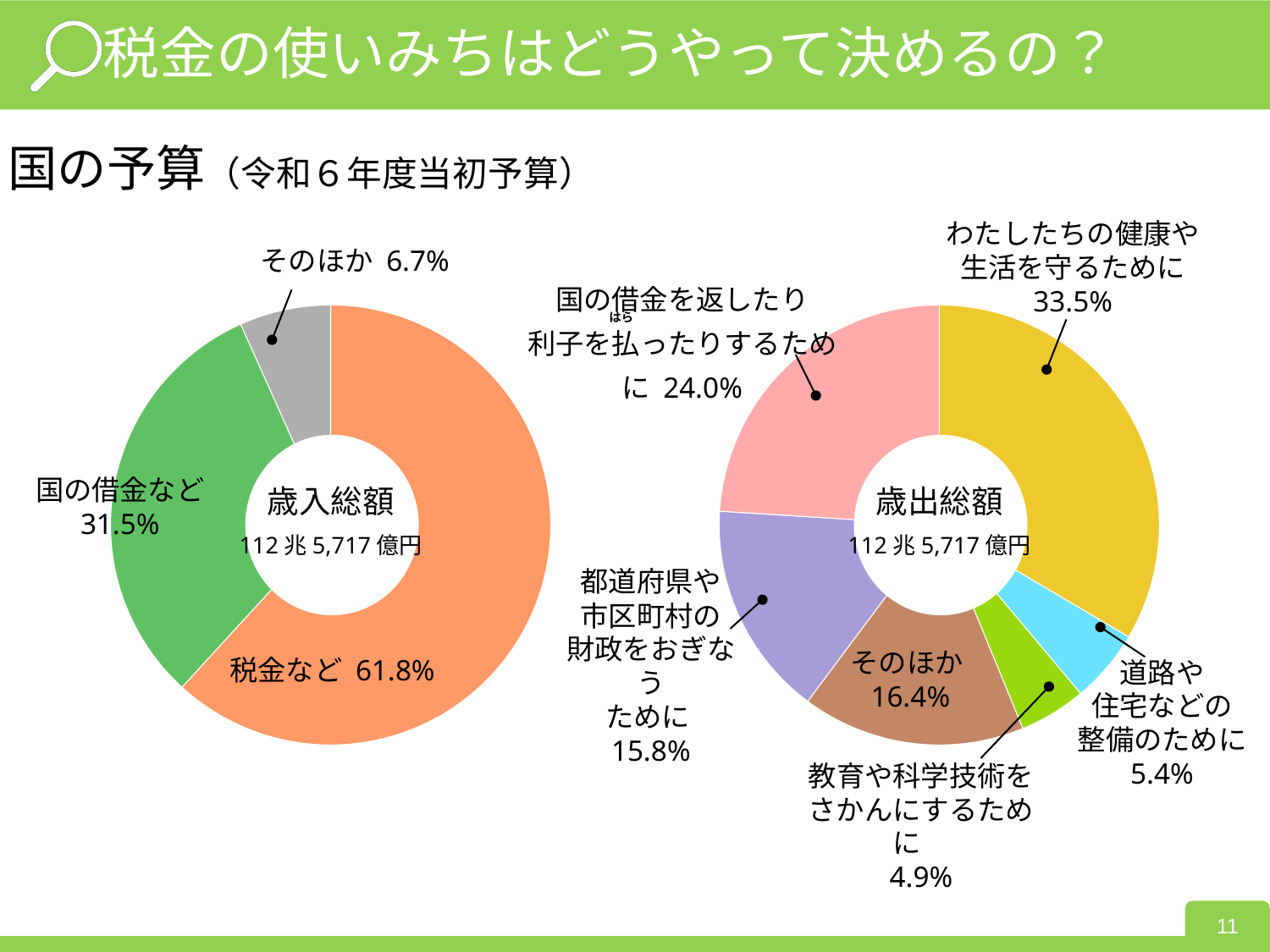
In the right chart (歳出総額), which category has the largest share? わたしたちの健康や生活を守るために In the left chart (歳入総額), what share is labelled for 税金など? 61.8% In the left chart (歳入総額), how many categories are shown? 3 In the right chart (歳出総額), how many categories are shown? 6 In the left chart (歳入総額), which category has the smallest share? そのほか In the left chart (歳入総額), what share is labelled for 国の借金など? 31.5% In the left chart (歳入総額), what is the difference between the shares for 税金など and 国の借金など? 30.3% What kind of chart is used on this slide? Pie (donut) chart In the right chart (歳出総額), what share is labelled for わたしたちの健康や生活を守るために? 33.5% What total amount is shown in the centre of the right chart (歳出総額)? 112兆5,717億円 In the right chart (歳出総額), what share is labelled for 教育や科学技術をさかんにするために? 4.9% In the right chart (歳出総額), which is larger: そのほか or 都道府県や市区町村の財政をおぎなうために? そのほか